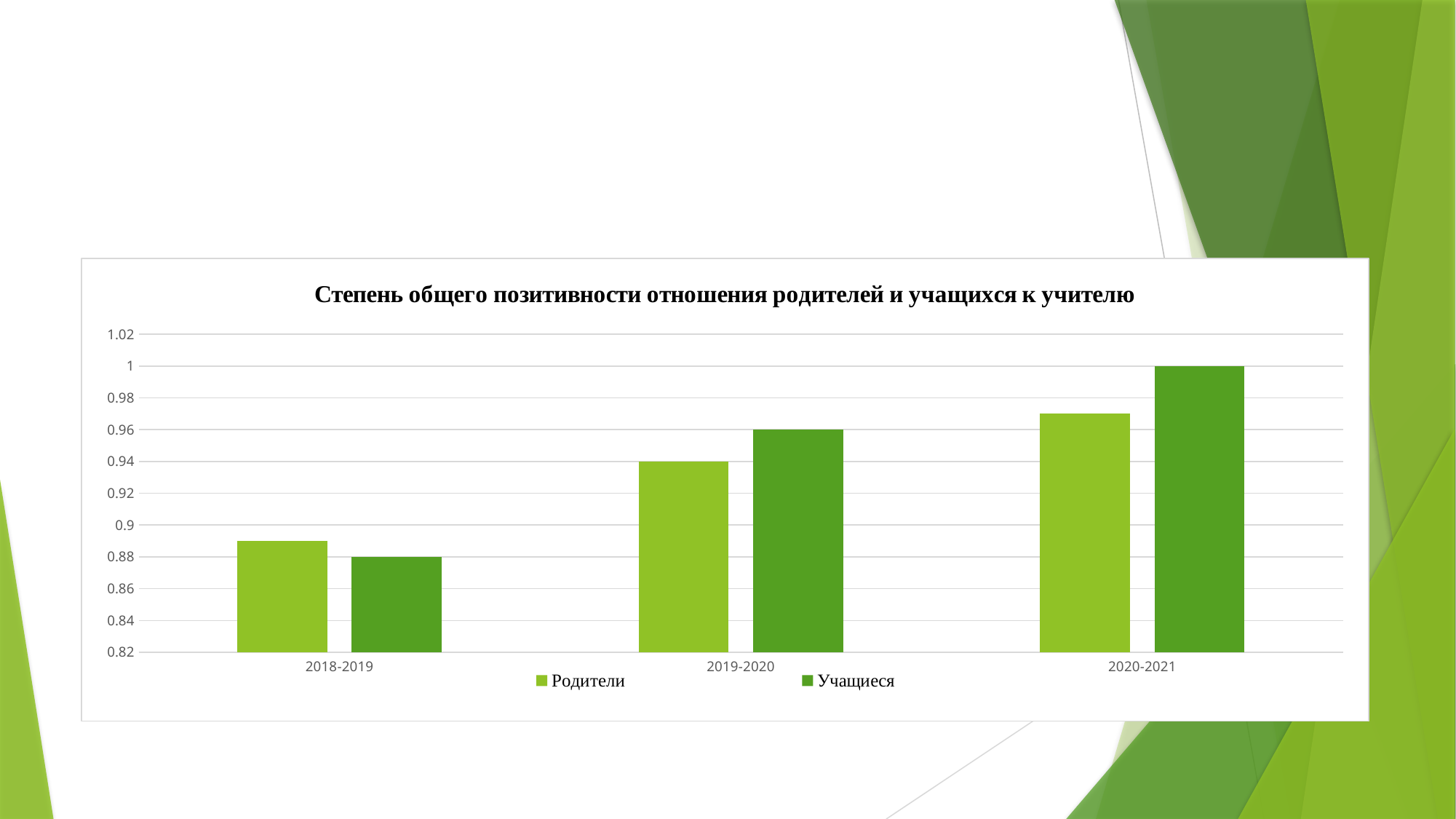
Do the values for Родители rise or fall from 2018-2019 to 2020-2021? rise What is the value for Учащиеся in 2020-2021? 1 Is the value for Родители in 2020-2021 greater or less than 0.96? greater What kind of chart is shown on the slide? bar chart How many series does the legend list? 2 How many categories (school years) are shown on the x axis? 3 What is the value for Родители in 2019-2020? 0.94 Which year has the highest value for Учащиеся? 2020-2021 What is the value for Учащиеся in 2019-2020? 0.96 Is the value for Родители in 2018-2019 greater or less than 0.9? less What is the title of the chart? Степень общего позитивности отношения родителей и учащихся к учителю What is the value for Учащиеся in 2018-2019? 0.88